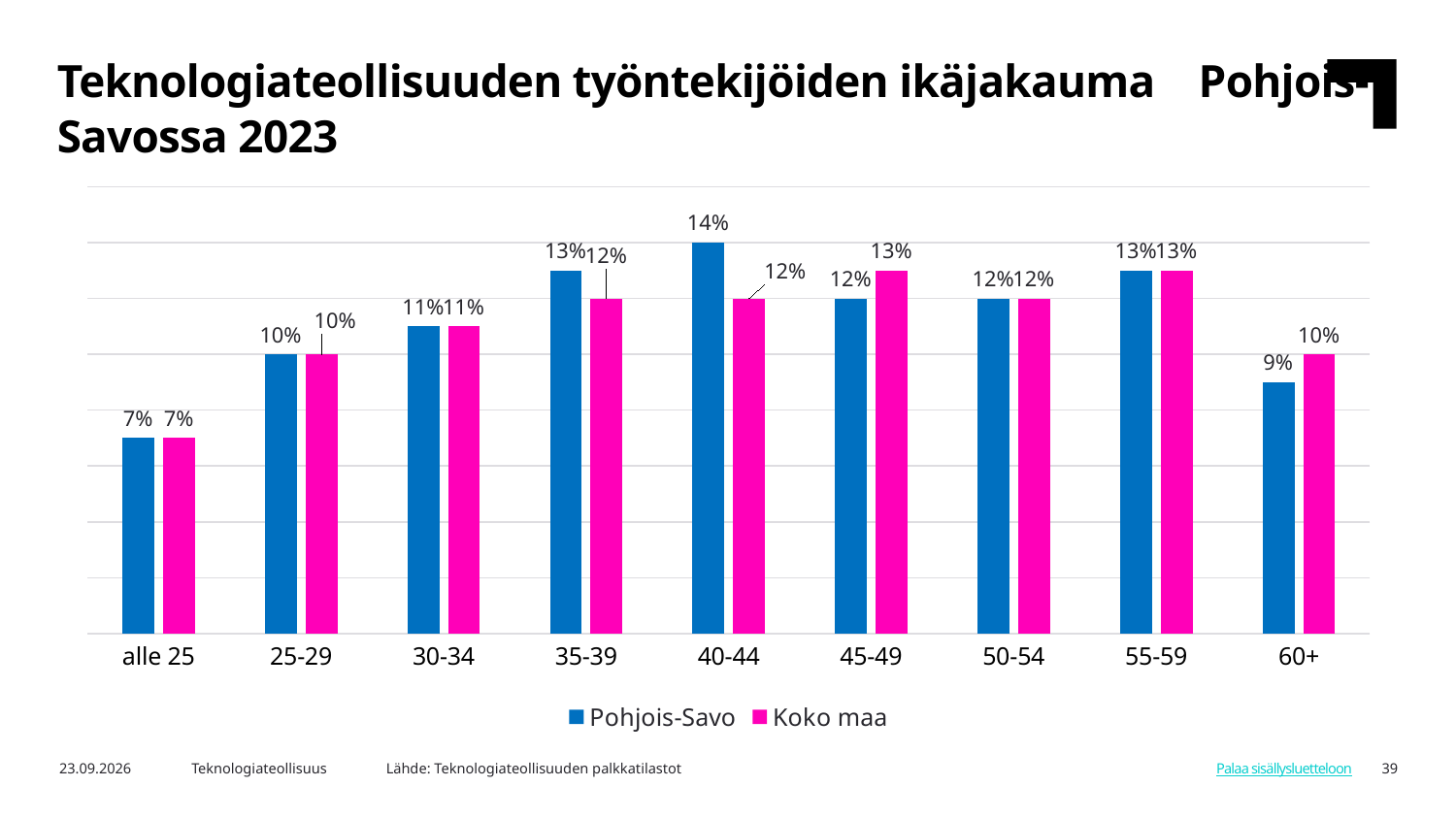
How many age groups are shown on the x axis? 9 What is the value for Pohjois-Savo in the 35-39 age group? 13% Which age group has the highest value for Pohjois-Savo? 40-44 What is the value for Koko maa in the 60+ age group? 10% Which age group has the lowest value for Koko maa? alle 25 What is the value for Koko maa in the 45-49 age group? 13% Do the Pohjois-Savo values rise or fall from the alle 25 group to the 40-44 group? Rise How many series does the legend list? 2 What is the difference between the Pohjois-Savo and Koko maa values in the 40-44 age group? 2 percentage points What is the value for Pohjois-Savo in the 40-44 age group? 14% In the 60+ age group, which series has the larger value, Pohjois-Savo or Koko maa? Koko maa What kind of chart is shown on the slide? Bar chart